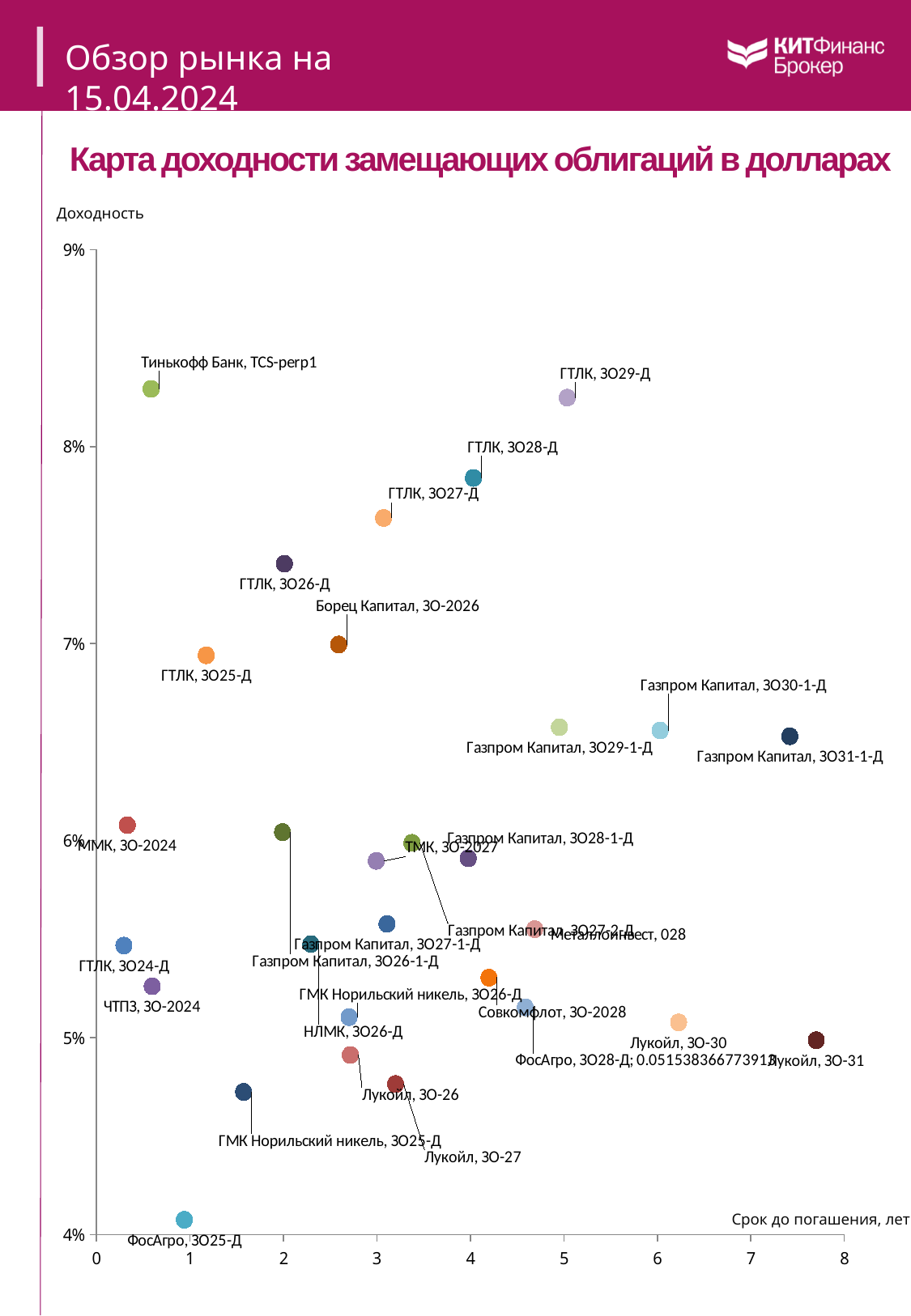
Is the yield for ФосАгро, ЗО25-Д greater or less than 5%? less Is the yield for ГМК Норильский никель, ЗО25-Д greater or less than 5%? less Is the yield for ГТЛК, ЗО26-Д greater or less than 7%? greater What kind of chart is shown on the slide? Scatter chart What is the label of the horizontal axis of the chart? Срок до погашения, лет Which has the higher yield, ГТЛК, ЗО28-Д or ГТЛК, ЗО27-Д? ГТЛК, ЗО28-Д Which has the higher yield, ММК, ЗО-2024 or ГТЛК, ЗО24-Д? ММК, ЗО-2024 What is the title of the chart? Карта доходности замещающих облигаций в долларах Which bond has the lowest yield (Доходность) on the chart? ФосАгро, ЗО25-Д